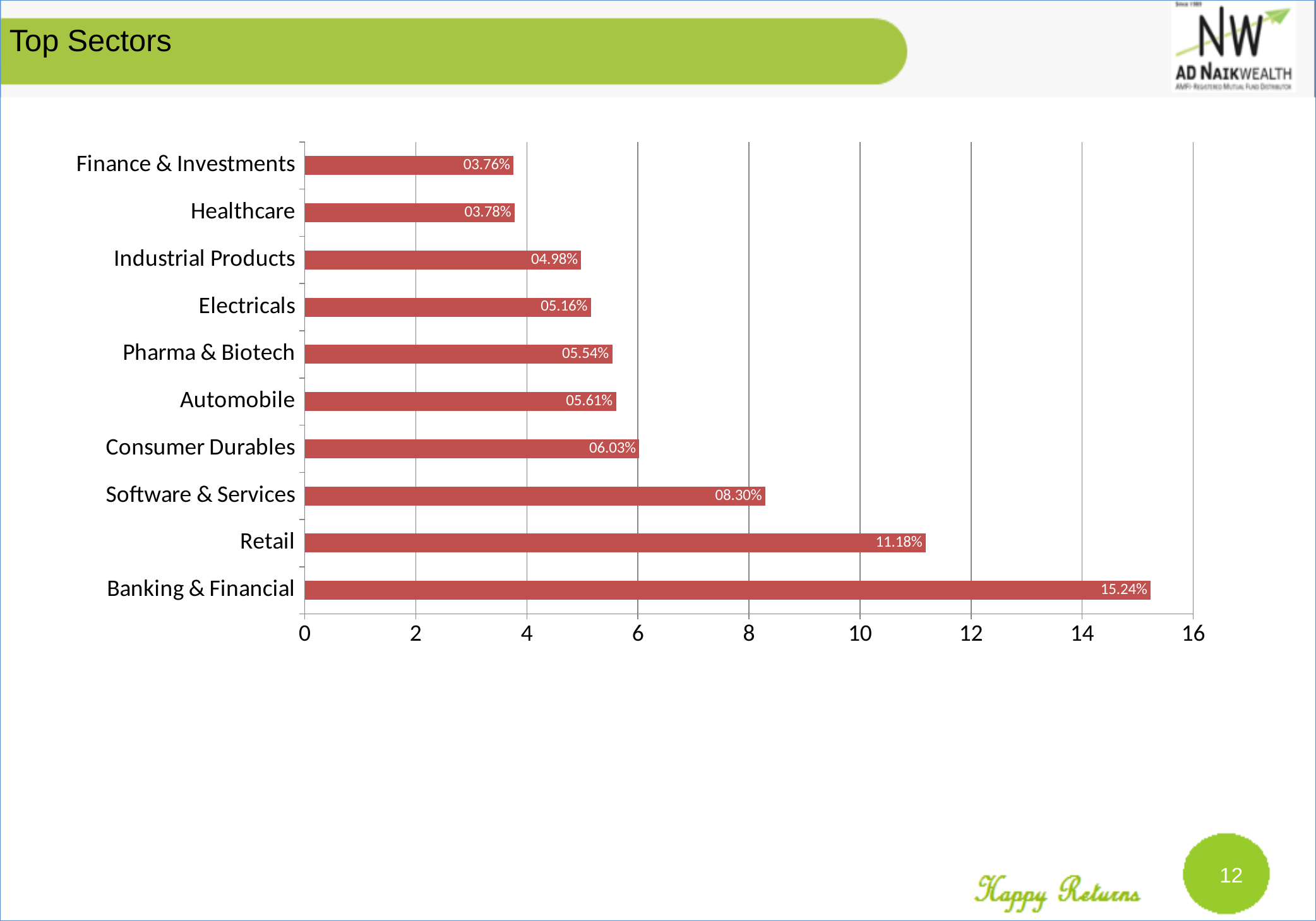
What is the value for Software & Services? 08.30% Which sector has the highest value? Banking & Financial Which is larger, the value for Consumer Durables or the value for Electricals? Consumer Durables Is the value for Retail greater or less than 10? greater What is the value for Banking & Financial? 15.24% Which sector has the lowest value? Finance & Investments What is the difference between the values for Banking & Financial and Retail? 4.06% What is the title of the slide? Top Sectors What is the value for Healthcare? 03.78% How many sectors are shown in the chart? 10 What kind of chart is shown on the slide? bar chart What is the difference between the values for Industrial Products and Finance & Investments? 1.22%